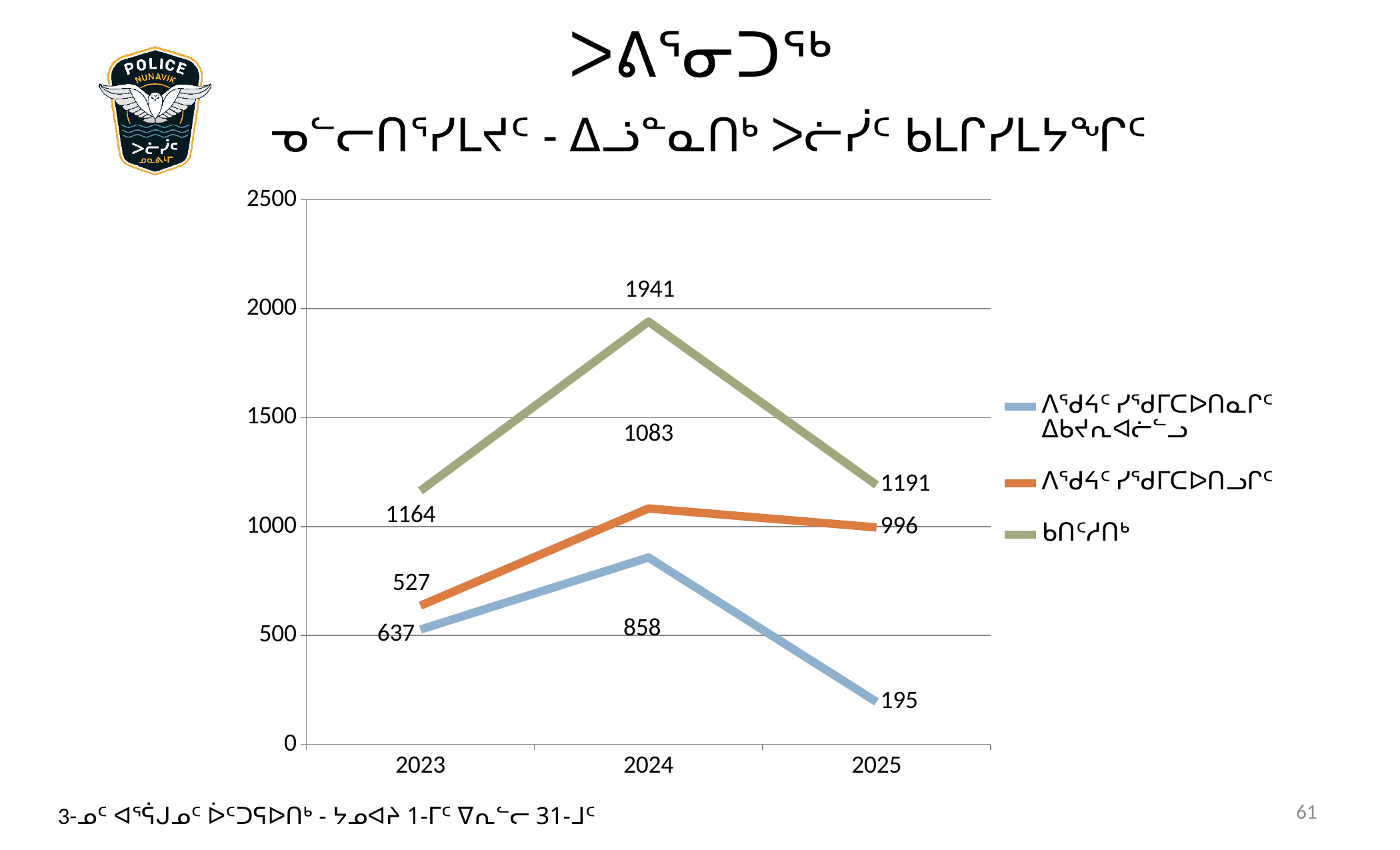
What is the difference between the green line's values in 2024 and 2025? 750 What is the value of the green line in 2023? 1164 What is the value of the orange line in 2024? 1083 What is the value of the blue line in 2025? 195 How many years are shown on the x axis? 3 In which year does the green line reach its highest value? 2024 Does the blue line rise or fall from 2024 to 2025? fall How many series does the legend list? 3 Is the value of the blue line in 2023 greater or less than 1000? less What is the value of the green line in 2024? 1941 What is the value of the green line in 2025? 1191 What kind of chart is shown on the slide? line chart